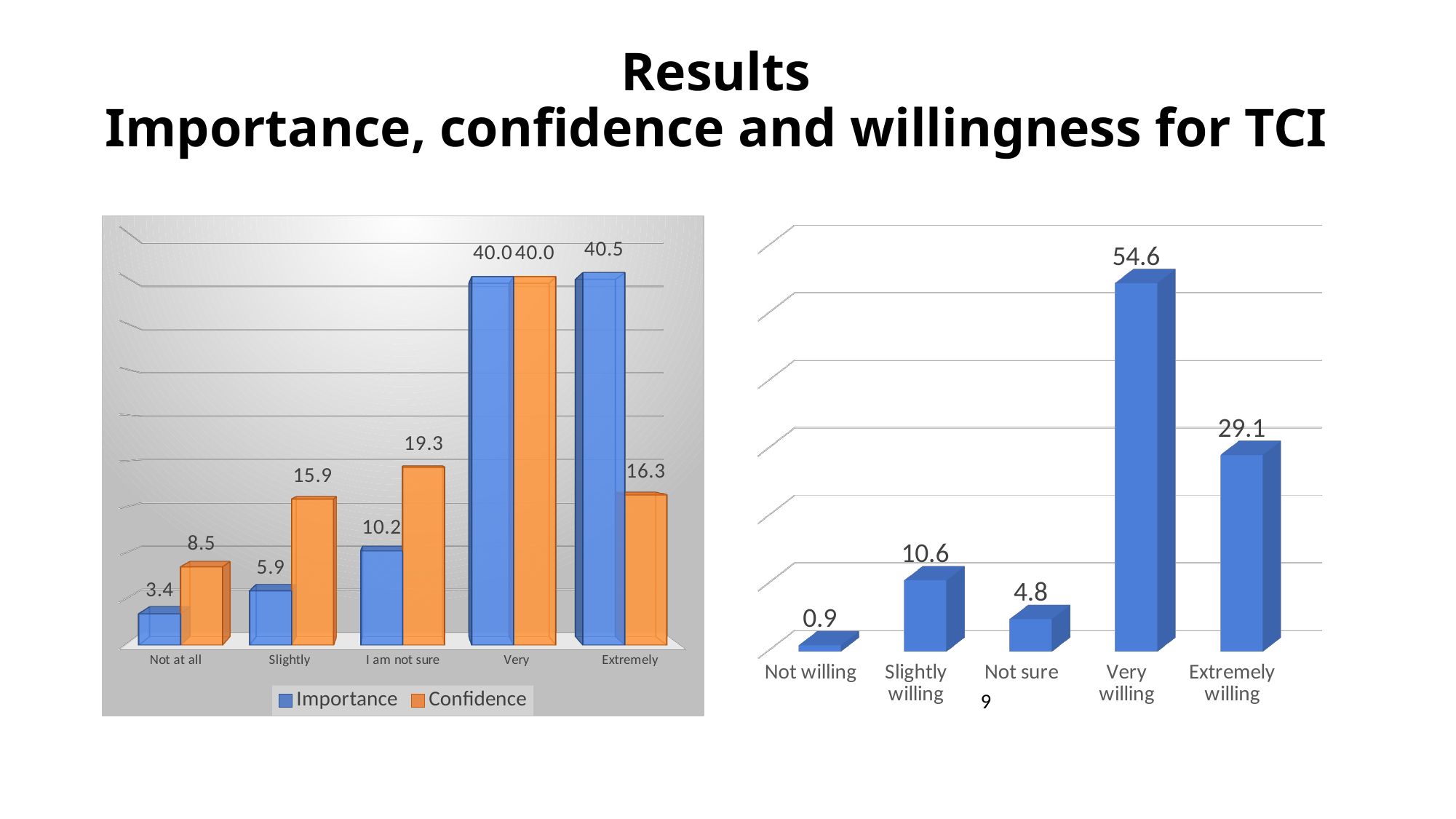
In the left chart, which category has the highest Importance value? Extremely In the left chart, what is the Importance value for 'Not at all'? 3.4 How many series does the legend of the left chart list? 2 How many categories are shown in the right chart? 5 In the left chart, which category has the lowest Confidence value? Not at all In the left chart, which is larger for 'Extremely': Importance or Confidence? Importance What kind of chart is the right chart? Bar chart In the right chart, which category has the lowest value? Not willing In the left chart, what is the difference between the Confidence and Importance values for 'Slightly'? 10.0 In the right chart, what is the value for 'Very willing'? 54.6 In the left chart, what is the Confidence value for 'I am not sure'? 19.3 In the right chart, what is the difference between 'Very willing' and 'Extremely willing'? 25.5